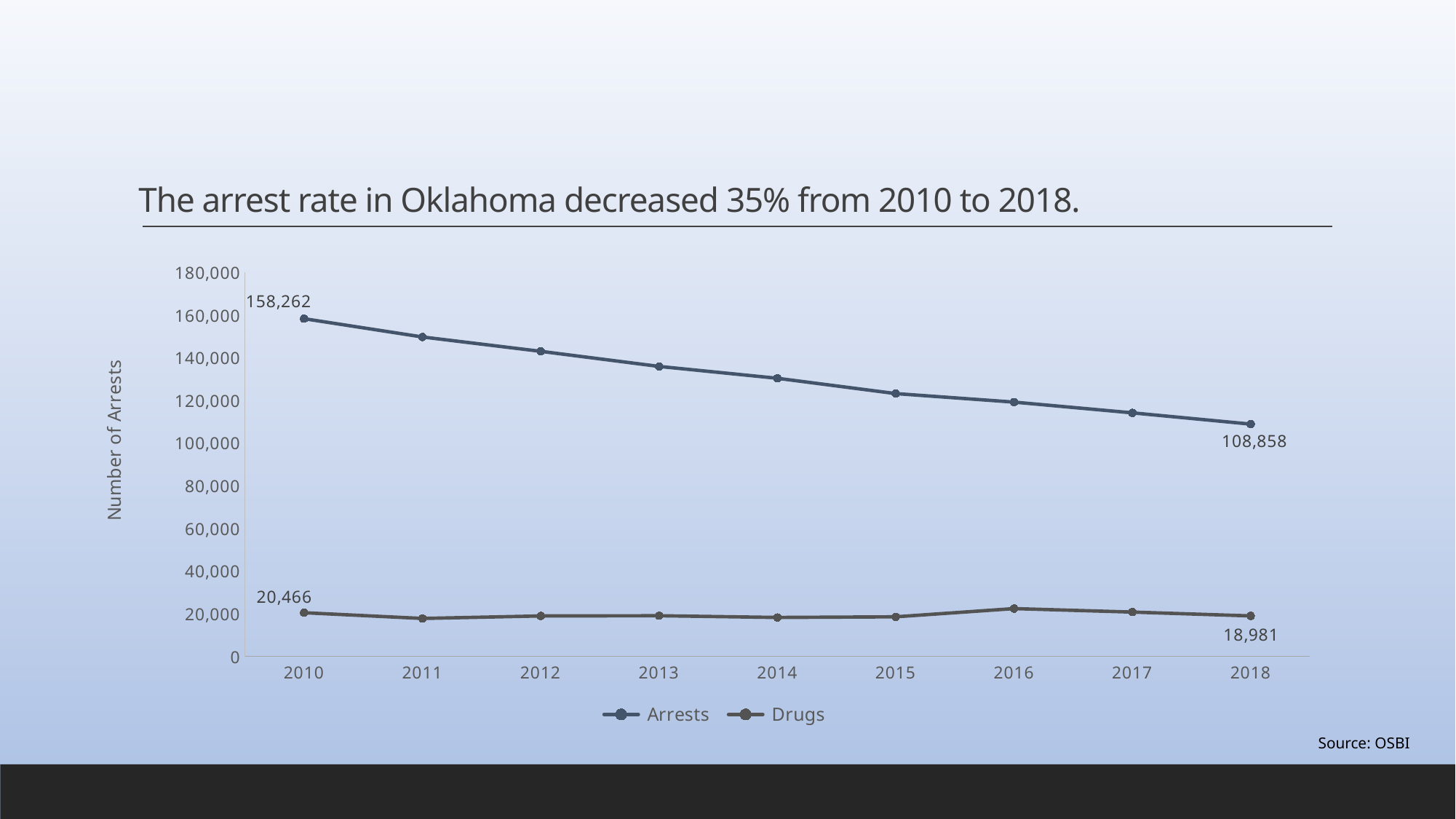
Which year has the highest value for the Arrests series? 2010 Which year has the lowest value for the Arrests series? 2018 Does the Arrests series rise or fall from 2010 to 2018? fall Is the Arrests value for 2014 greater or less than 120,000? greater What kind of chart is shown on the slide? line chart By how much did the Arrests value fall from 2010 to 2018? 49,404 What is the value of the Arrests series in 2018? 108,858 What is the difference between the Drugs values in 2010 and 2018? 1,485 What is the value of the Drugs series in 2010? 20,466 How many series does the legend list? 2 What is the value of the Arrests series in 2010? 158,262 What is the value of the Drugs series in 2018? 18,981